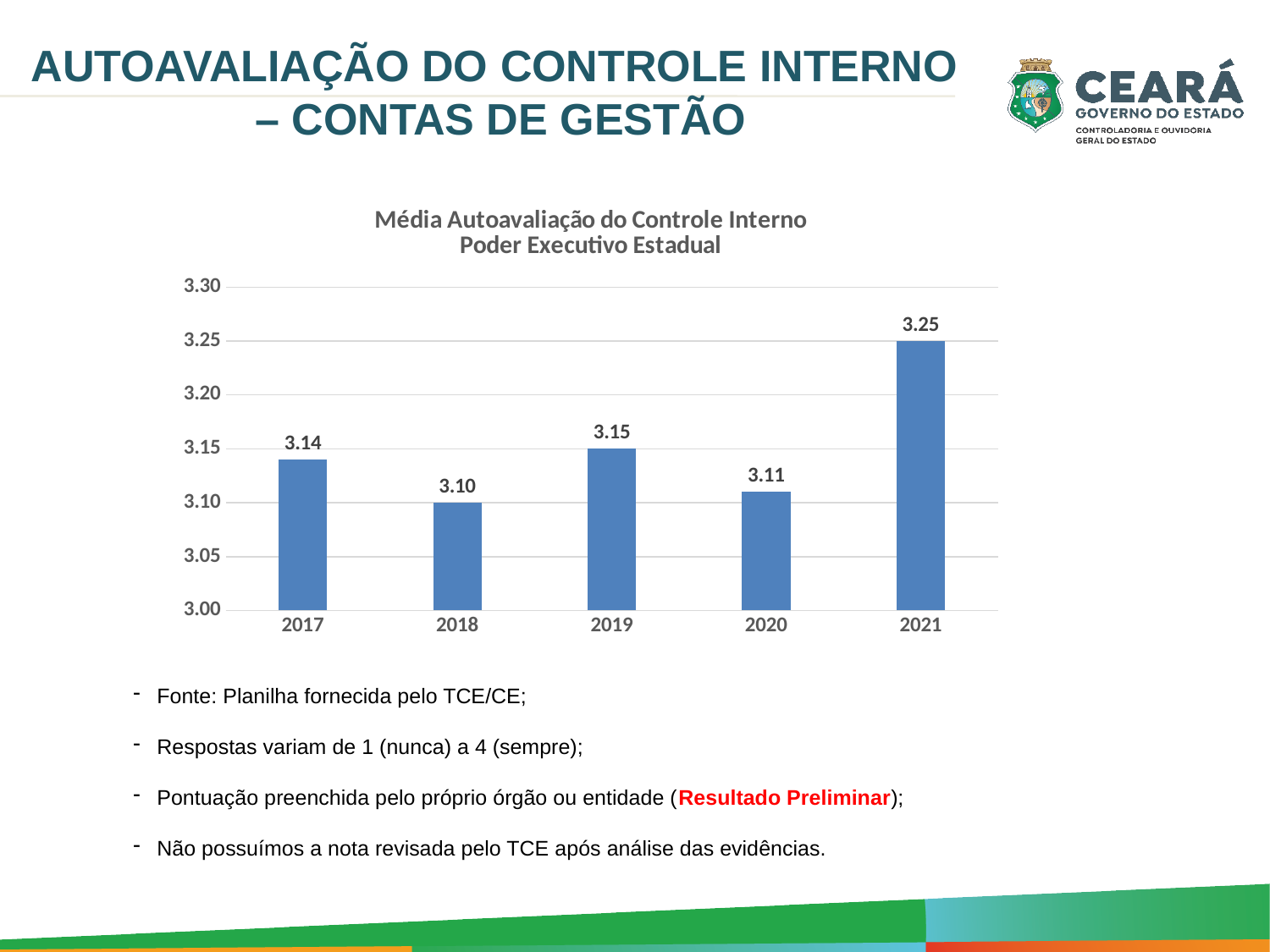
Which year has the lowest value? 2018 What is the value for 2017? 3.14 How many years are shown on the x axis? 5 What is the value for 2020? 3.11 What is the value for 2021? 3.25 Does the value rise or fall from 2020 to 2021? rise Which year has the highest value? 2021 What is the difference between the values for 2021 and 2018? 0.15 Which is larger, the value for 2019 or the value for 2020? 2019 Is the value for 2021 greater or less than 3.20? greater What kind of chart is shown on the slide? bar chart What is the title of the chart? Média Autoavaliação do Controle Interno Poder Executivo Estadual